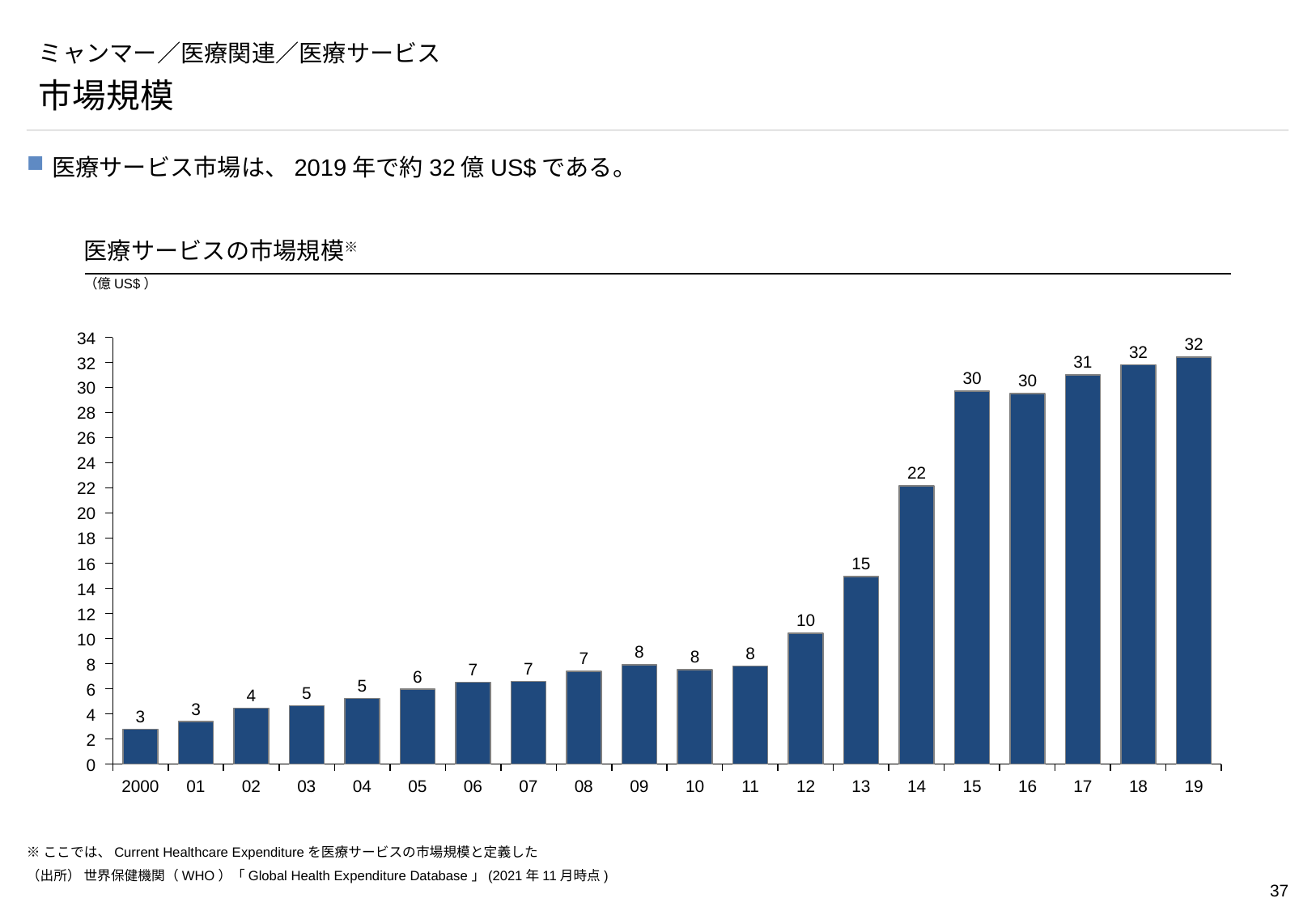
What is the difference between the values for 2019 and 2000? 29 What is the value for 2014 in the chart? 22 What is the difference between the values for 2014 and 2013? 7 How many years (bars) are shown in the chart? 20 Is the value for 2012 greater or less than 8? greater Is the value for 2011 greater or less than 10? less Do the values generally rise or fall from 2000 to 2019? rise What is the value for 2019 in the chart? 32 What kind of chart is shown on the slide? bar chart What is the value for 2000 in the chart? 3 What is the value for 2013 in the chart? 15 Which is larger, the value for 2014 or the value for 2013? 2014